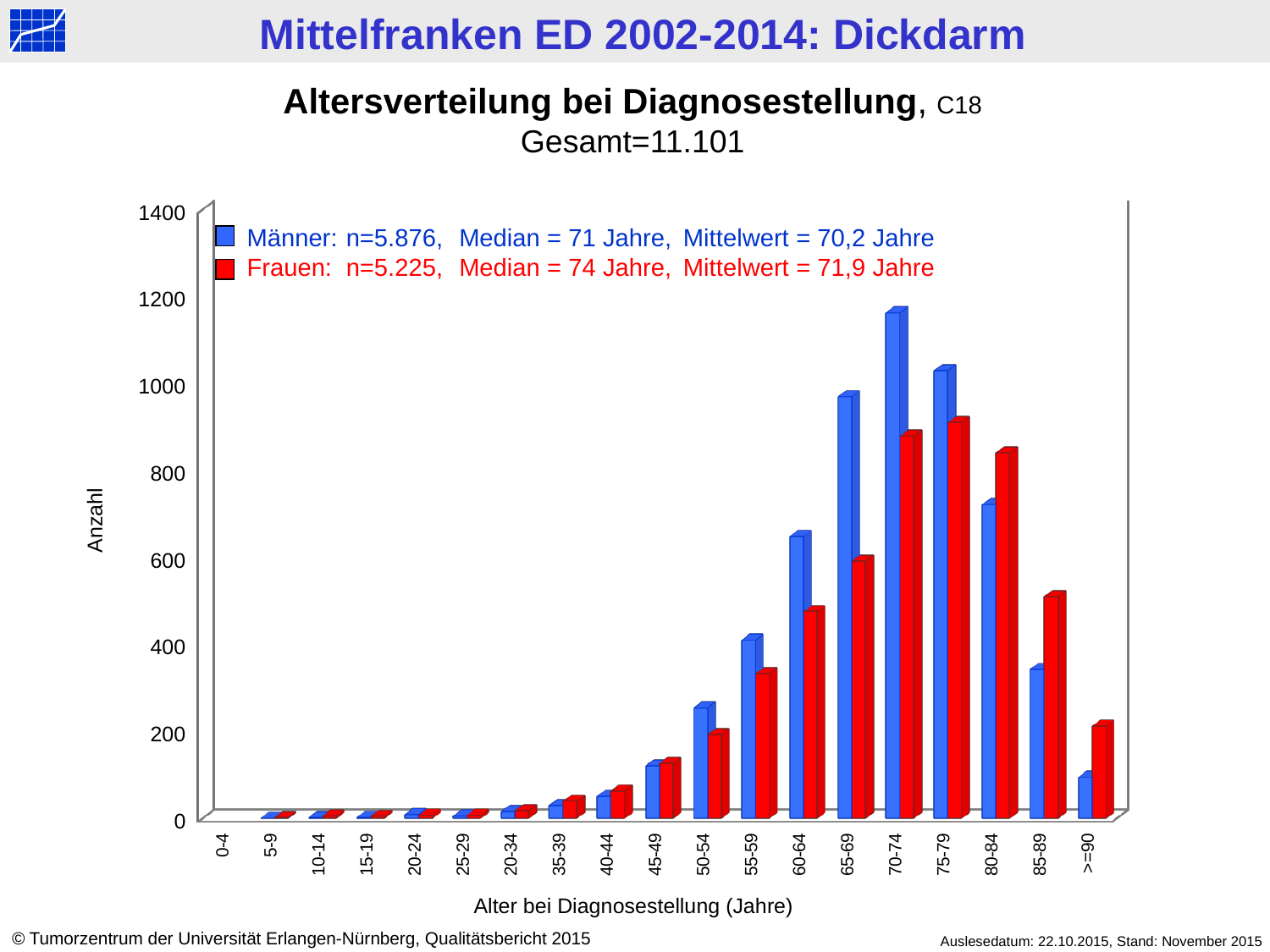
According to the legend, what is n for Männer? 5.876 Is the value for Männer in the >=90 age group greater or less than 200? less Is the value for Frauen in the 85-89 age group greater or less than 400? greater What kind of chart is shown on the slide? bar chart In the 80-84 age group, which series has the larger value, Männer or Frauen? Frauen Which age group has the highest value for Frauen? 75-79 How many age groups are shown on the x axis? 19 Do the Männer values rise or fall from the 40-44 age group to the 70-74 age group? rise Is the value for Männer in the 70-74 age group greater or less than 1000? greater In the 70-74 age group, which series has the larger value, Männer or Frauen? Männer How many series does the legend list? 2 Which age group has the highest value for Männer? 70-74